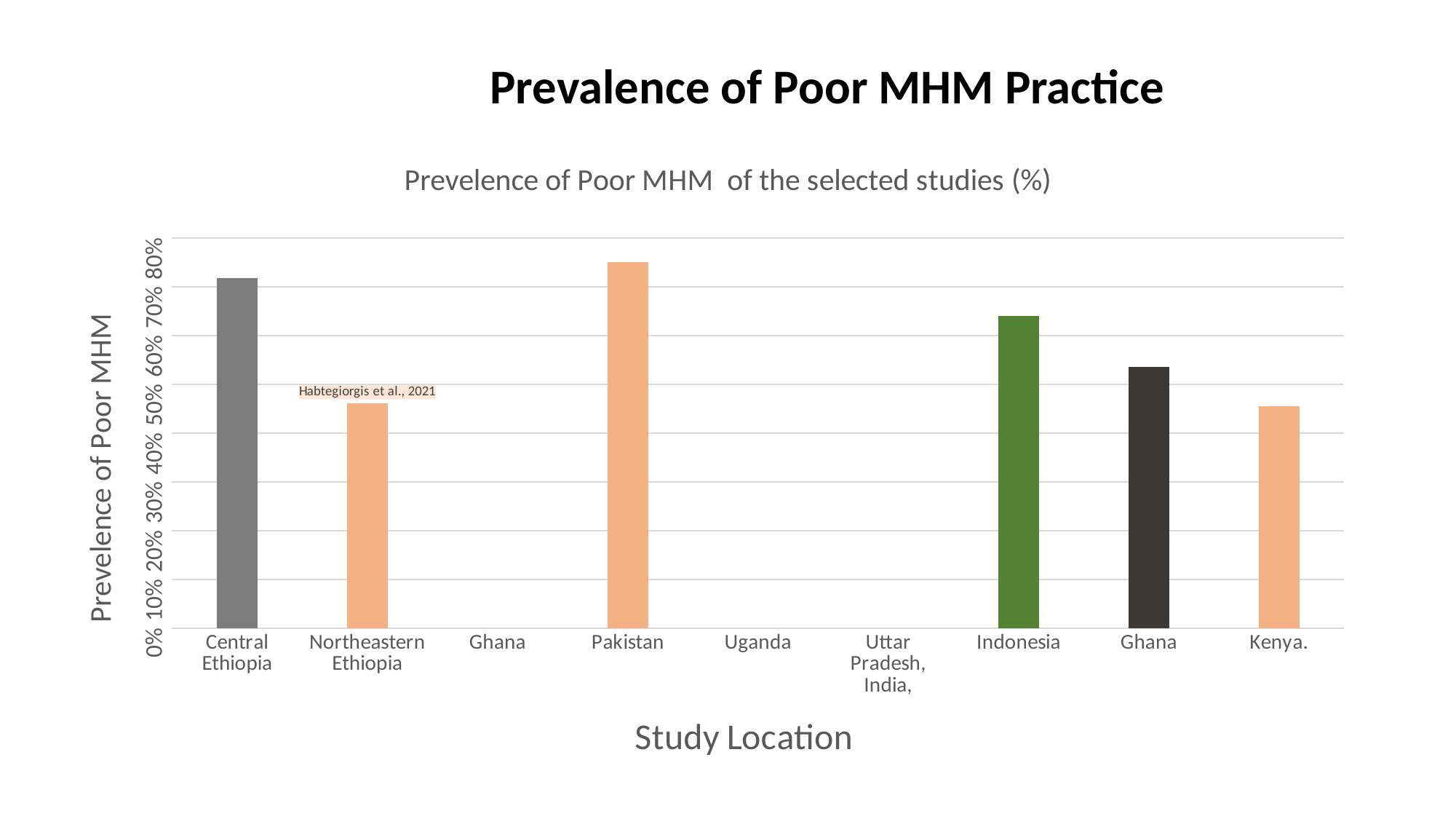
What is the chart's title shown above the plot area? Prevelence of Poor MHM of the selected studies (%) Is the value for Indonesia greater or less than 60%? greater Which has a larger value, Pakistan or Central Ethiopia? Pakistan Is the value for Kenya greater or less than 50%? less Is the value for Northeastern Ethiopia greater or less than 50%? less How many study location labels are shown on the x axis? 9 Which study location has the highest prevalence of poor MHM? Pakistan What is the label of the x axis? Study Location Which has a larger value, Indonesia or Central Ethiopia? Central Ethiopia What kind of chart is shown on the slide? bar chart